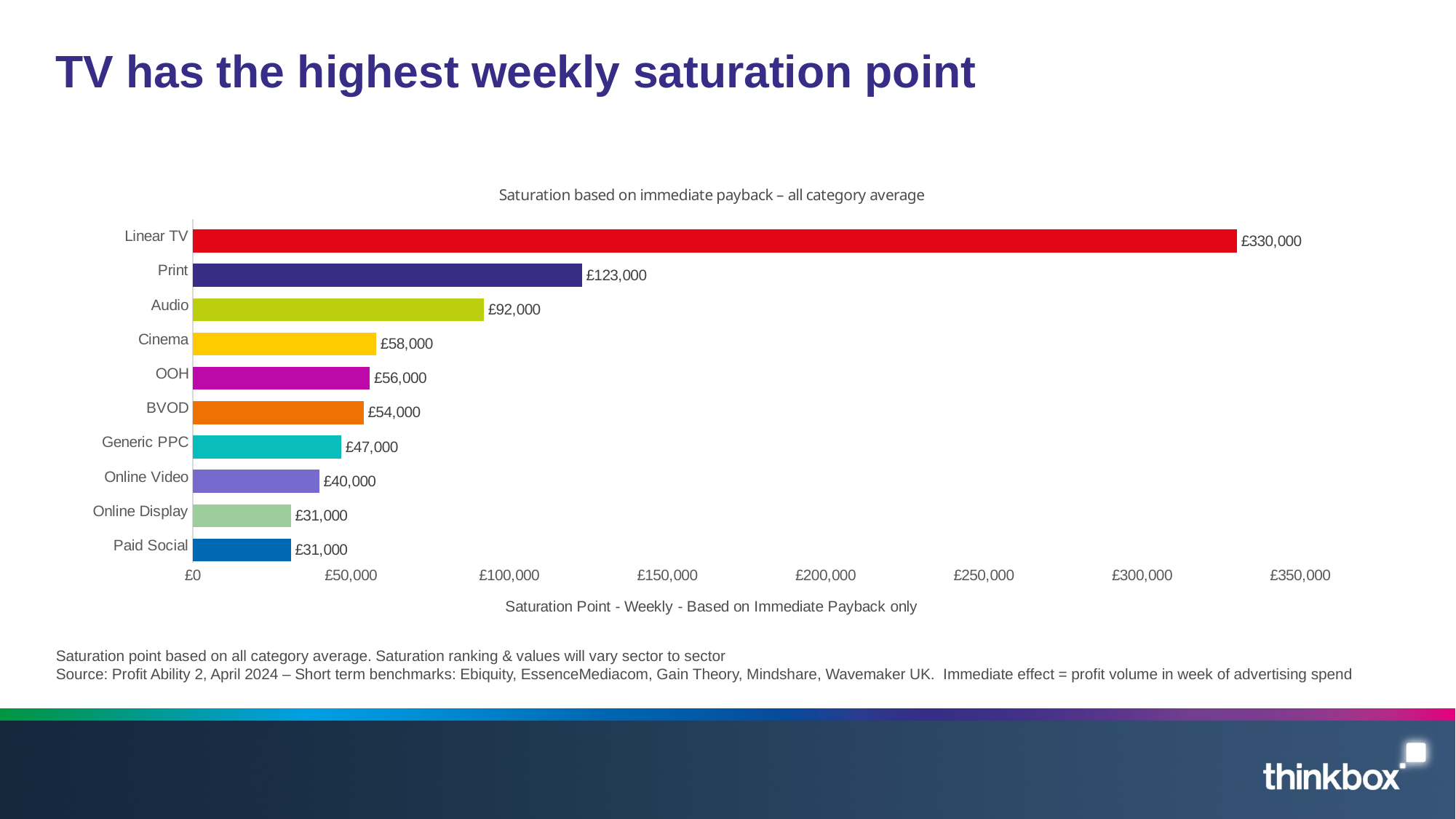
Which category has the highest saturation point? Linear TV Is the value for Print greater or less than £100,000? greater What is the saturation point for Audio? £92,000 What is the title of the chart? Saturation based on immediate payback – all category average What is the difference between the saturation points of Cinema and OOH? £2,000 How many categories are shown in the chart? 10 Which has a larger saturation point, BVOD or Online Video? BVOD What is the saturation point for Linear TV? £330,000 Which has a larger saturation point, Print or Audio? Print What kind of chart is shown on the slide? Bar chart What is the saturation point for Generic PPC? £47,000 What is the difference between the saturation points of Linear TV and Print? £207,000